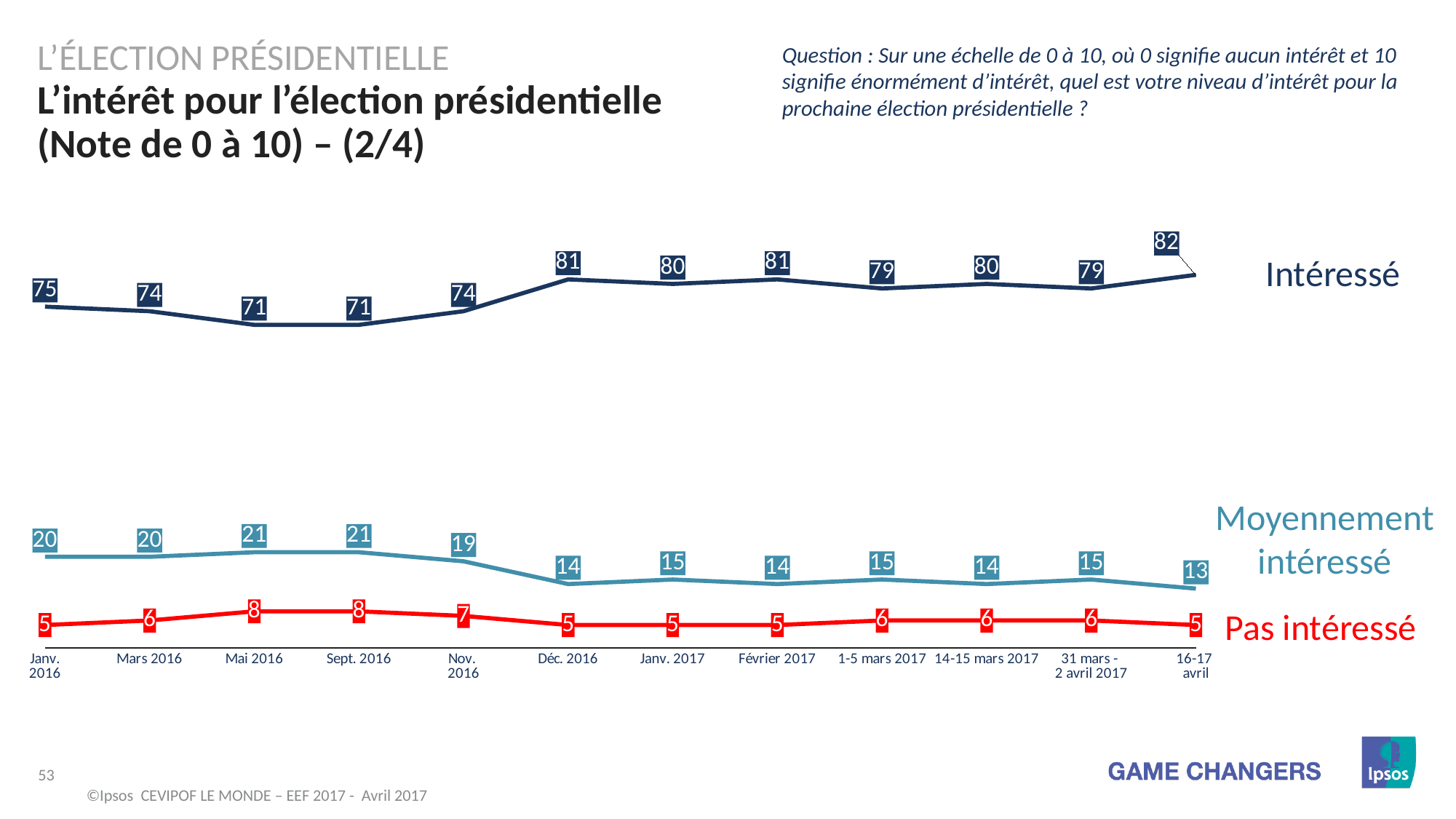
What is the value for 'Pas intéressé' in Mai 2016? 8 What is the difference between the 'Intéressé' value in Déc. 2016 and in Nov. 2016? 7 What is the value for 'Moyennement intéressé' in Nov. 2016? 19 How many time points are shown along the x axis? 12 What is the value for 'Intéressé' at 16-17 avril? 82 At which time point is the 'Moyennement intéressé' series lowest? 16-17 avril What kind of chart is shown on the slide? Line chart What is the total of the three series' values at Janv. 2016? 100 How many series are plotted on the chart? 3 Does the 'Intéressé' series generally rise or fall from Janv. 2016 to 16-17 avril? Rise At which time point is the 'Intéressé' series highest? 16-17 avril Which is larger: the 'Moyennement intéressé' value in Sept. 2016 or in Janv. 2017? Sept. 2016